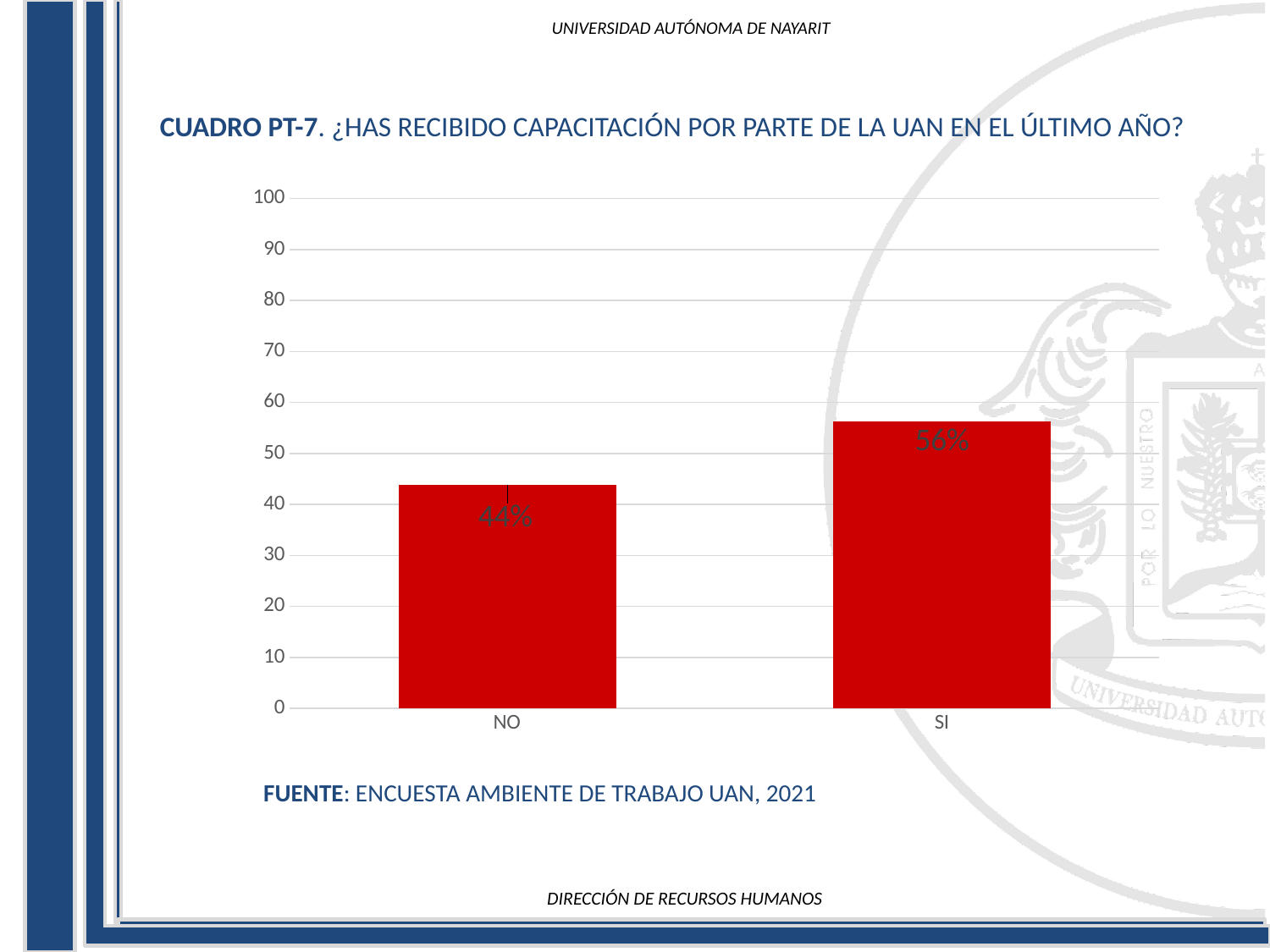
Which category has the lowest value? NO What is the value for SI? 56% Is the value for NO greater or less than 50? less What is the maximum value shown on the y axis? 100 What is the source cited below the chart? ENCUESTA AMBIENTE DE TRABAJO UAN, 2021 Which is larger, the value for NO or the value for SI? SI What is the value for NO? 44% What is the difference between the values for SI and NO? 12% What kind of chart is shown on the slide? bar chart How many categories are shown on the x axis? 2 Which category has the highest value? SI Is the value for SI greater or less than 50? greater